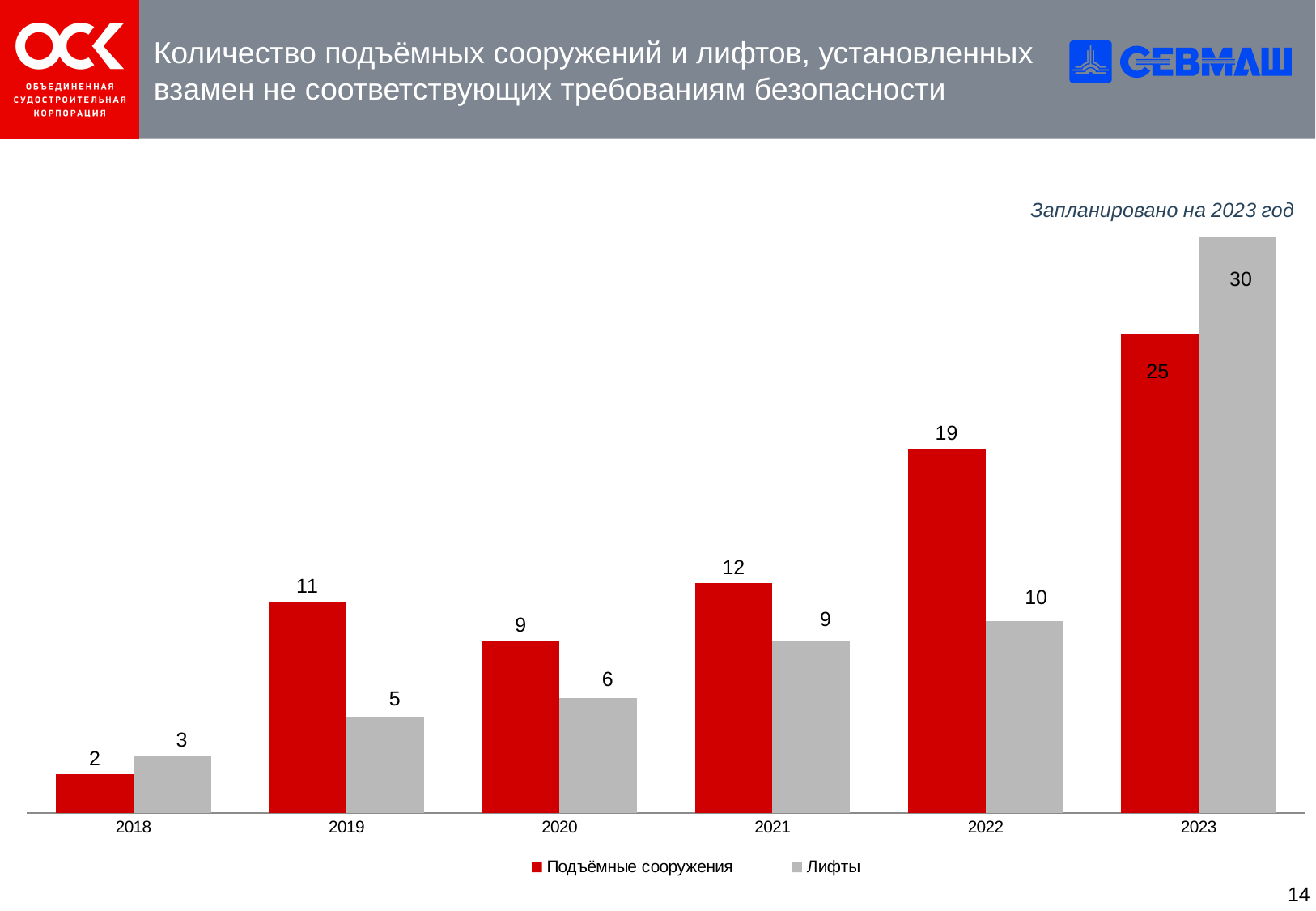
What is the value for Лифты in 2020? 6 Does the value for Подъёмные сооружения rise or fall from 2020 to 2023? Rise What kind of chart is shown on the slide? Bar chart How many years are shown on the x axis? 6 What is the difference between Подъёмные сооружения and Лифты in 2021? 3 Which year has the highest value for Лифты? 2023 Which colour represents Лифты in the legend? Grey What is the value for Подъёмные сооружения in 2022? 19 What is the total of Подъёмные сооружения and Лифты in 2023? 55 Which year has the lowest value for Подъёмные сооружения? 2018 How many series does the legend list? 2 Which is larger in 2019: Подъёмные сооружения or Лифты? Подъёмные сооружения